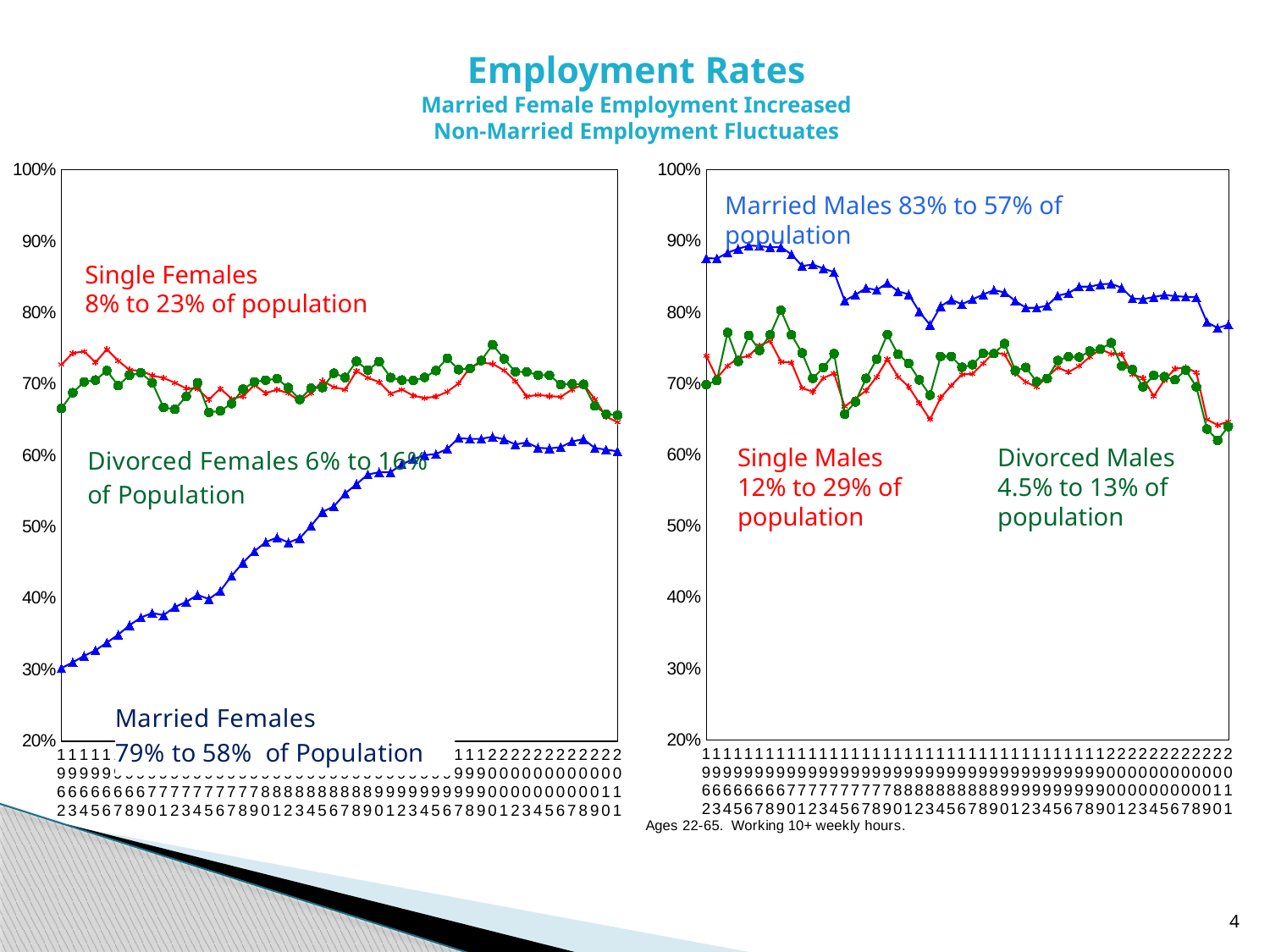
In the left chart, does the Married Females line generally rise or fall from left to right? rise In the left chart, at the start of the period, which is higher: the Single Females line or the Married Females line? Single Females According to the annotation on the right chart, Married Males went from what share of the population to what share? 83% to 57% How many series are plotted in the right chart? 3 What kind of chart is the left chart on the slide? line chart How many series are plotted in the left chart? 3 What is the main title of the slide? Employment Rates In the right chart, at the start of the period, which is higher: the Married Males line or the Single Males line? Married Males In the right chart, does the Married Males line generally rise or fall from left to right? fall What kind of chart is the right chart on the slide? line chart In the left chart, is the first value of the Married Females line greater or less than 40%? less In the right chart, is the first value of the Married Males line greater or less than 80%? greater